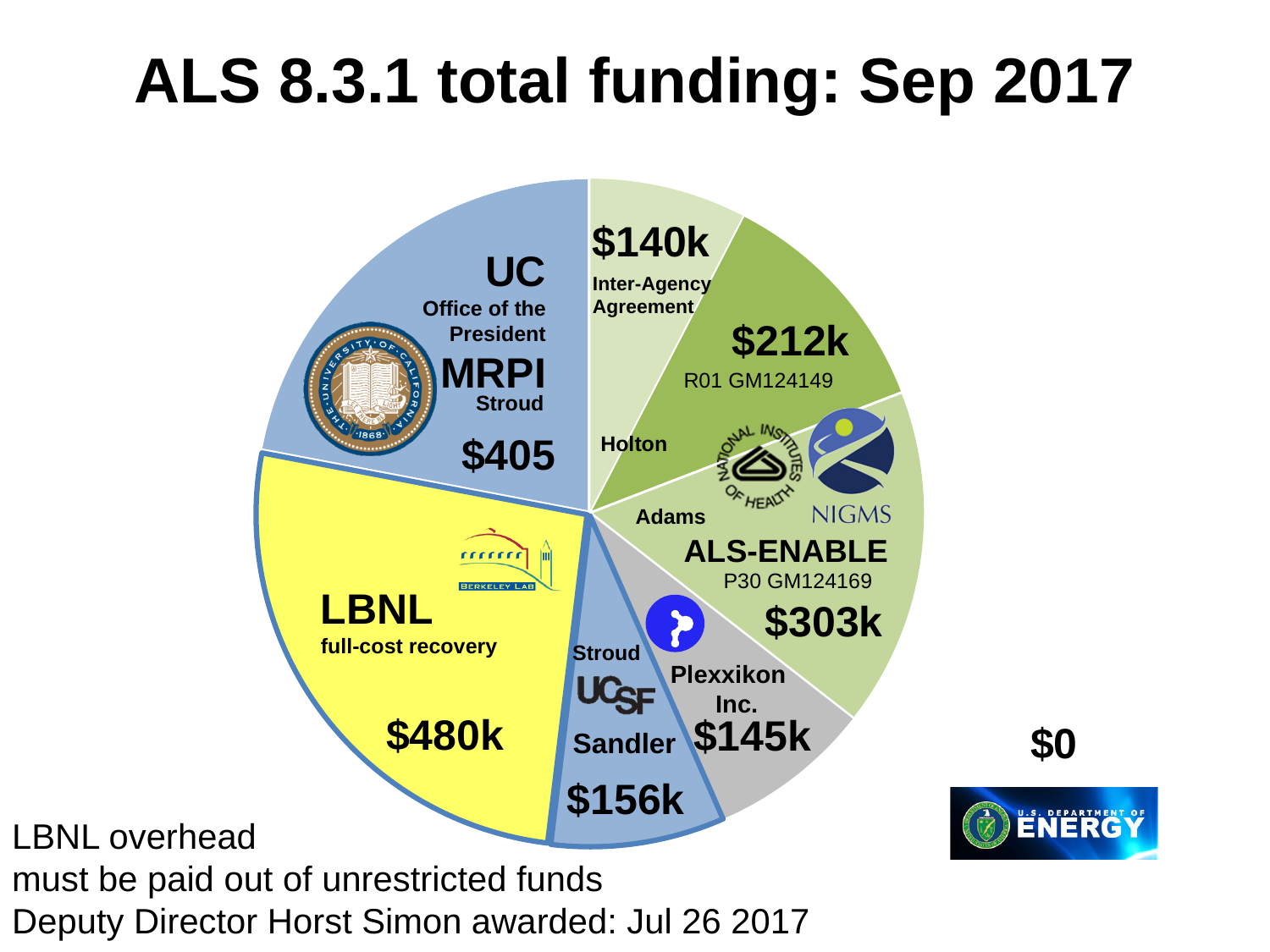
Which slice of the pie has the largest funding value? LBNL full-cost recovery Which slice of the pie has the smallest funding value? Inter-Agency Agreement How many slices does the pie chart have? 7 What is the funding value for the ALS-ENABLE P30 GM124169 slice? $303k What is the funding value for the LBNL full-cost recovery slice? $480k What is the difference between the LBNL full-cost recovery value and the UCSF Sandler value? $324k What is the funding value for the Plexxikon Inc. slice? $145k What is the funding value for the R01 GM124149 (Holton) slice? $212k What is the funding value for the Inter-Agency Agreement slice? $140k What is the title of the chart? ALS 8.3.1 total funding: Sep 2017 Which is larger, the ALS-ENABLE P30 GM124169 value or the R01 GM124149 value? ALS-ENABLE P30 GM124169 What type of chart is shown on the slide? pie chart